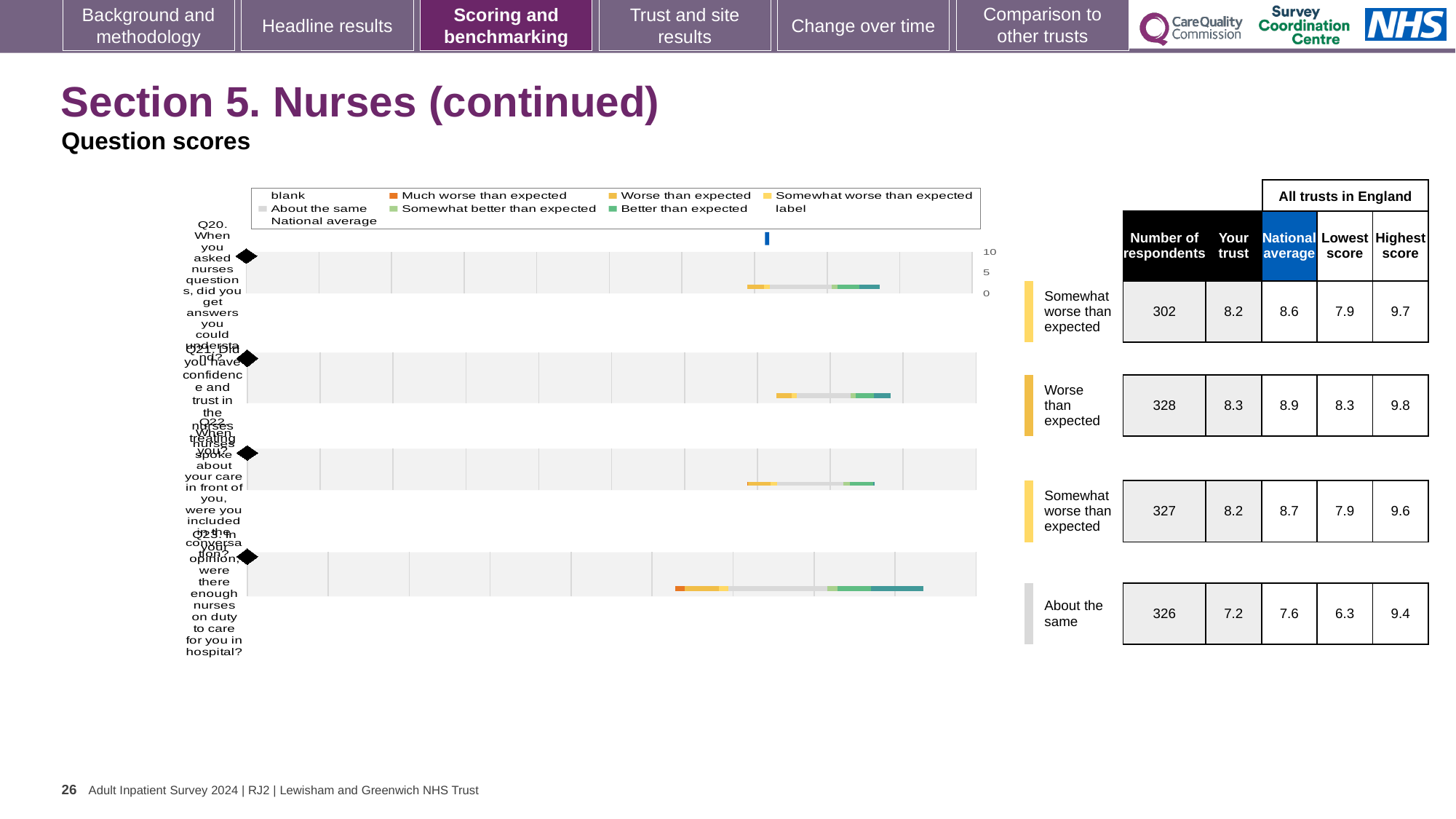
What is the national average score for Q23 (were there enough nurses on duty to care for you in hospital?)? 7.6 What kind of chart is used to show the question scores? Bar chart How many questions are plotted on the chart? 4 What is the 'Your trust' score for Q20 (When you asked nurses questions, did you get answers you could understand?)? 8.2 Which benchmark category is Q21 (confidence and trust in the nurses) placed in? Worse than expected How many respondents answered Q21 (Did you have confidence and trust in the nurses treating you?)? 328 What is the highest score across all trusts in England for Q22 (were you included in the conversation?)? 9.6 For Q23, what is the difference between the highest score and the lowest score across all trusts in England? 3.1 Which has the larger national average score, Q20 or Q22? Q22 For Q21, how much higher is the national average than the 'Your trust' score? 0.6 Which question has the highest 'Your trust' score? Q21 Which question has the lowest 'Your trust' score? Q23